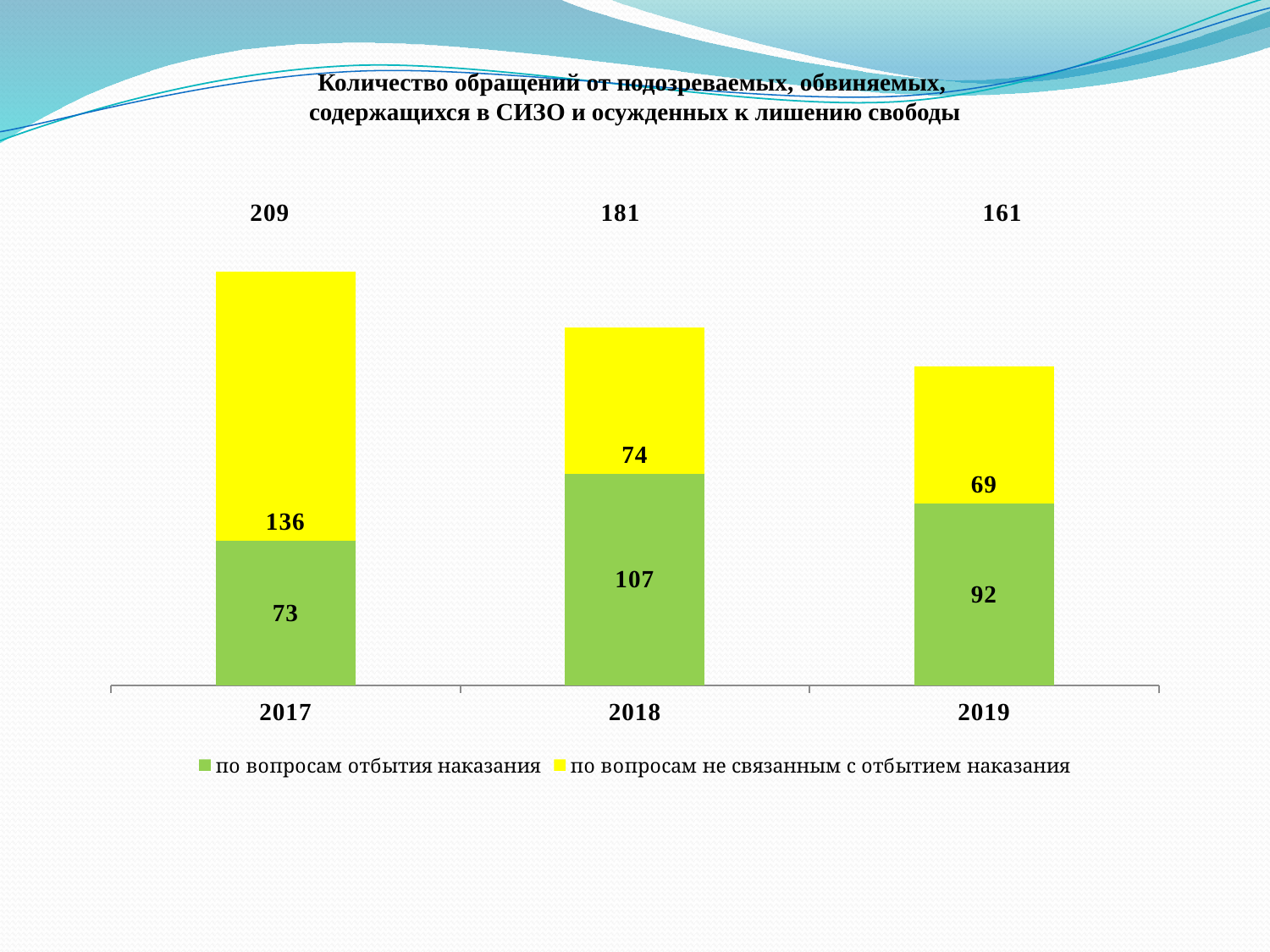
Which colour represents 'по вопросам не связанным с отбытием наказания'? yellow What is the value for 'по вопросам отбытия наказания' in 2017? 73 What is the difference between the 'по вопросам не связанным с отбытием наказания' values for 2017 and 2018? 62 What kind of chart is shown on the slide? stacked bar chart What is the total of the stacked bar for 2018? 181 How many years are shown on the x axis? 3 Which is larger in 2019: 'по вопросам отбытия наказания' or 'по вопросам не связанным с отбытием наказания'? по вопросам отбытия наказания What is the value for 'по вопросам не связанным с отбытием наказания' in 2019? 69 Which year has the lowest value for 'по вопросам отбытия наказания'? 2017 Which year has the highest total number of appeals? 2017 How many series does the legend list? 2 Do the total values rise or fall from 2017 to 2019? fall